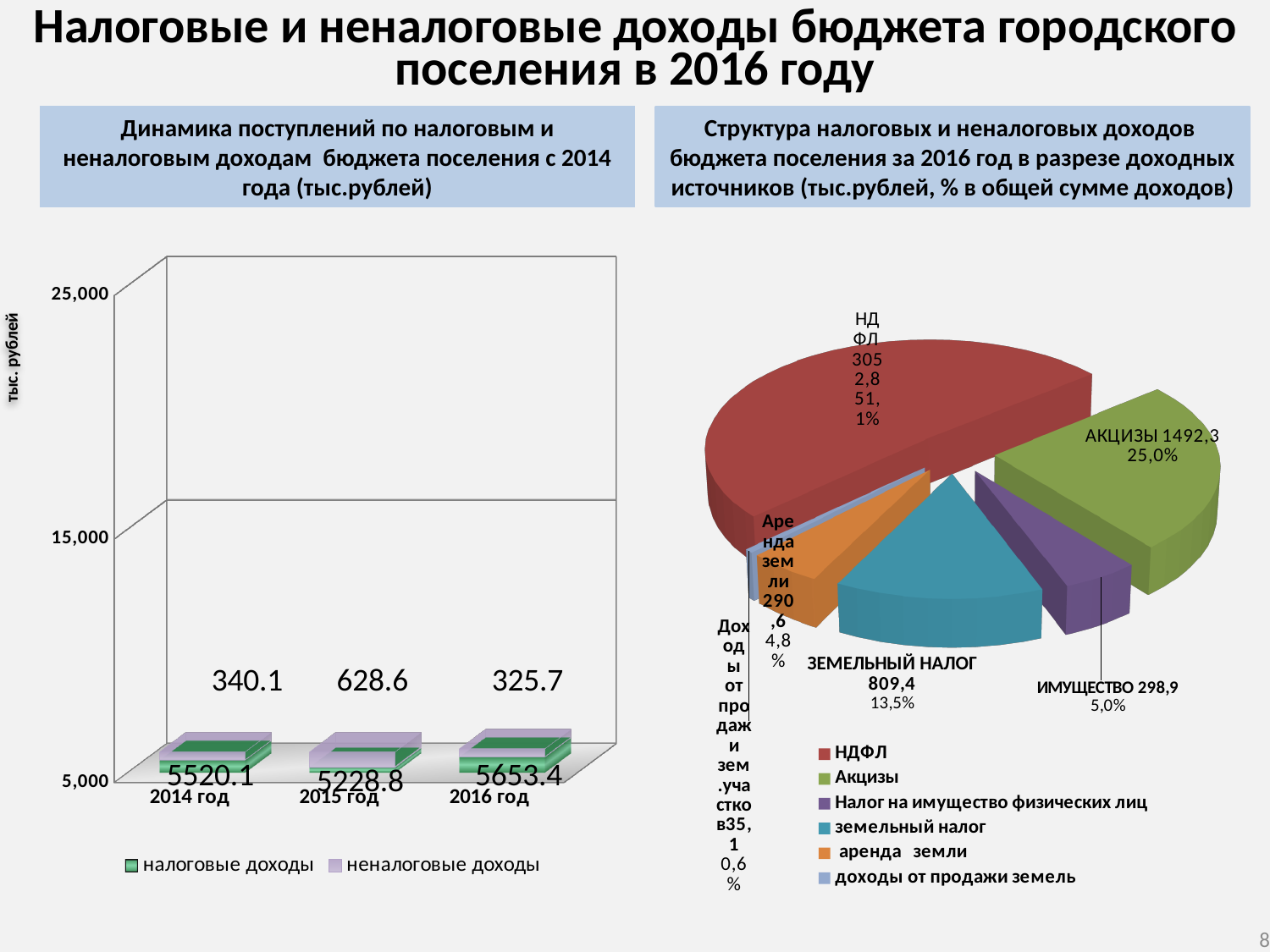
On the left chart (Динамика поступлений), what is the value of неналоговые доходы for 2015 год? 628.6 On the right chart (Структура налоговых и неналоговых доходов), which is larger: Имущество or Аренда земли? Имущество On the right chart (Структура налоговых и неналоговых доходов), what share of total income does Акцизы represent? 25,0% On the right chart (Структура налоговых и неналоговых доходов), how many income sources does the legend list? 6 On the left chart (Динамика поступлений), which year has the highest value of налоговые доходы? 2016 год On the left chart (Динамика поступлений), what is the difference between налоговые доходы in 2016 год and 2015 год? 424.6 On the right chart (Структура налоговых и неналоговых доходов), what is the value for Земельный налог? 809,4 On the right chart (Структура налоговых и неналоговых доходов), which income source has the largest slice? НДФЛ On the left chart (Динамика поступлений), how many series does the legend list? 2 On the left chart (Динамика поступлений), what is the value of налоговые доходы for 2016 год? 5653.4 On the left chart (Динамика поступлений), what kind of chart is shown? bar chart On the left chart (Динамика поступлений), which year has the lowest value of неналоговые доходы? 2016 год